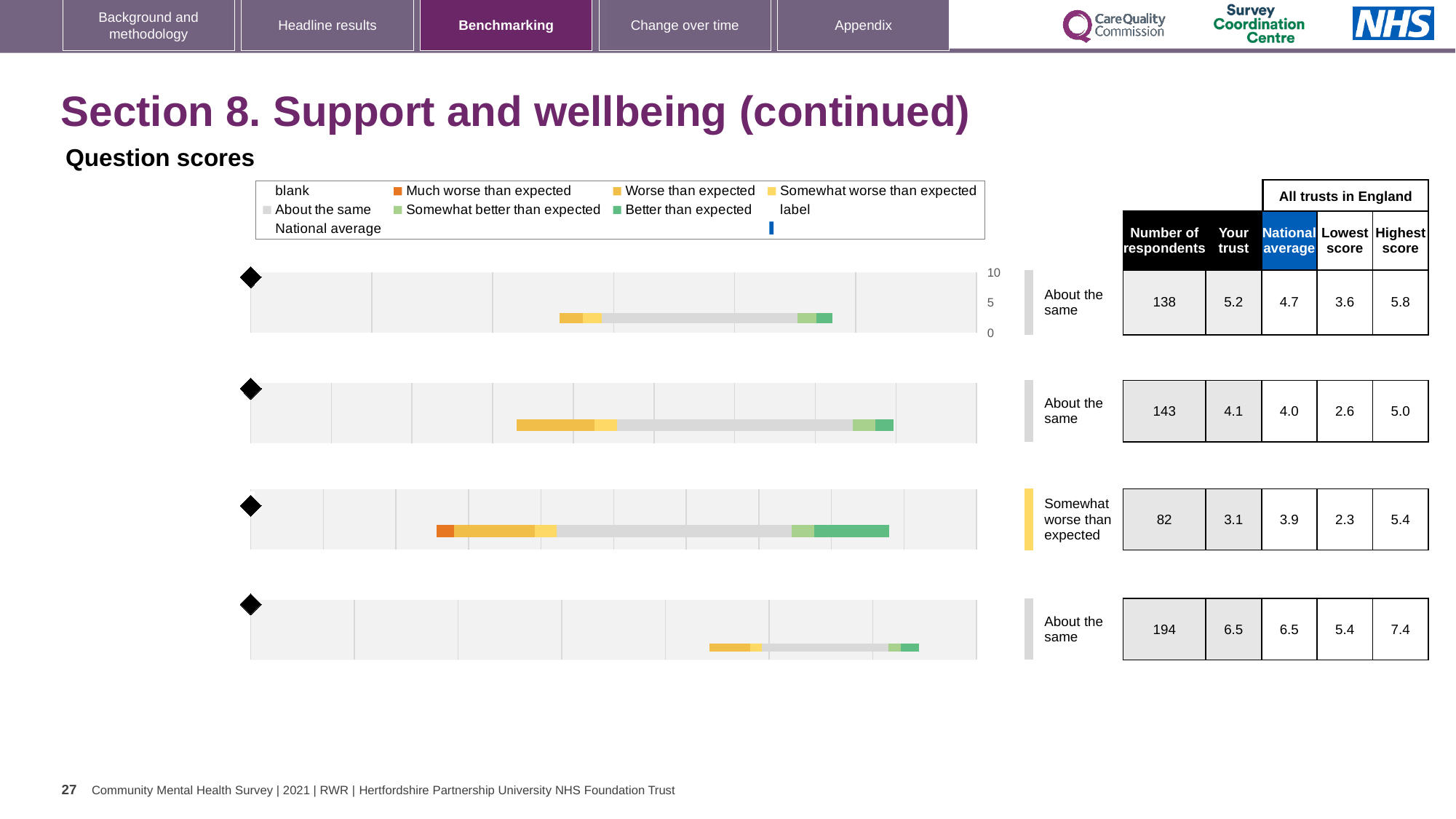
Which chart has the fewest respondents? The third chart from the top For the third chart from the top, which is larger: the 'Your trust' score or the national average? National average For the second chart from the top, what is the national average score? 4.0 For the first (top) chart, what is the 'Your trust' score? 5.2 What kind of chart is used for the four question-score charts on the slide? bar chart For the first (top) chart, which is larger: the 'Your trust' score or the national average? Your trust How many question-score charts are shown on the slide? 4 For the first (top) chart, what is the difference between the highest score and the lowest score? 2.2 For the fourth (bottom) chart, what is the highest score among all trusts in England? 7.4 For the third chart from the top, how many respondents are there? 82 Which chart has the highest 'Your trust' score? The fourth (bottom) chart What benchmark category is shown next to the third chart from the top? Somewhat worse than expected